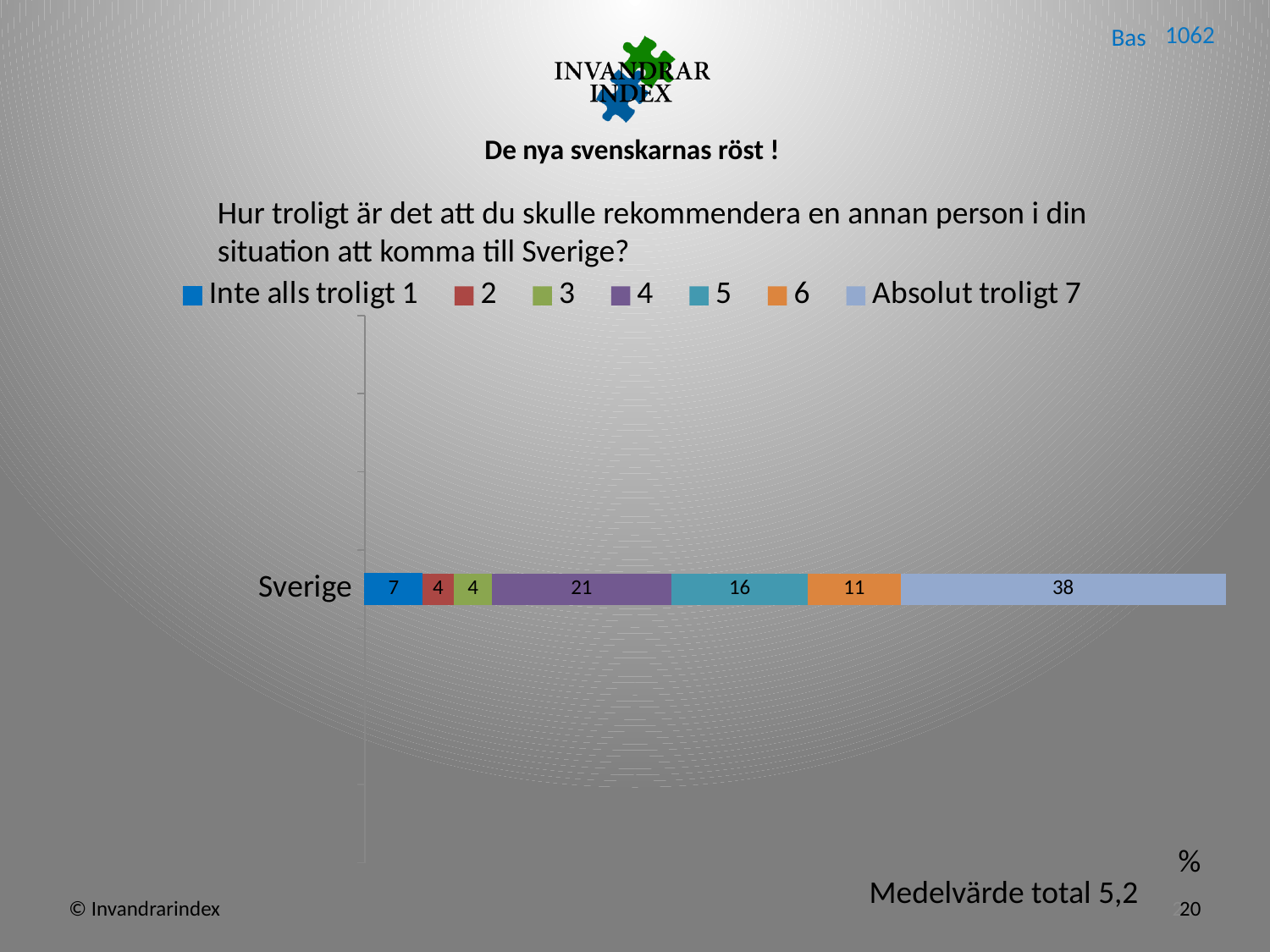
What value is shown for the '4' segment of the Sverige bar? 21 What value is shown for the '5' segment of the Sverige bar? 16 Which series has the largest segment in the Sverige bar? Absolut troligt 7 How many series does the legend list? 7 What is the 'Medelvärde total' shown on the slide? 5,2 What is the difference between the 'Absolut troligt 7' segment and the '4' segment in the Sverige bar? 17 What value is shown for the 'Absolut troligt 7' segment of the Sverige bar? 38 Which is larger in the Sverige bar, the '5' segment or the '6' segment? 5 What kind of chart is shown on the slide? Stacked bar chart What value is shown for the 'Inte alls troligt 1' segment of the Sverige bar? 7 How many categories are plotted on the chart? 1 What is the total of all segments in the Sverige bar? 101